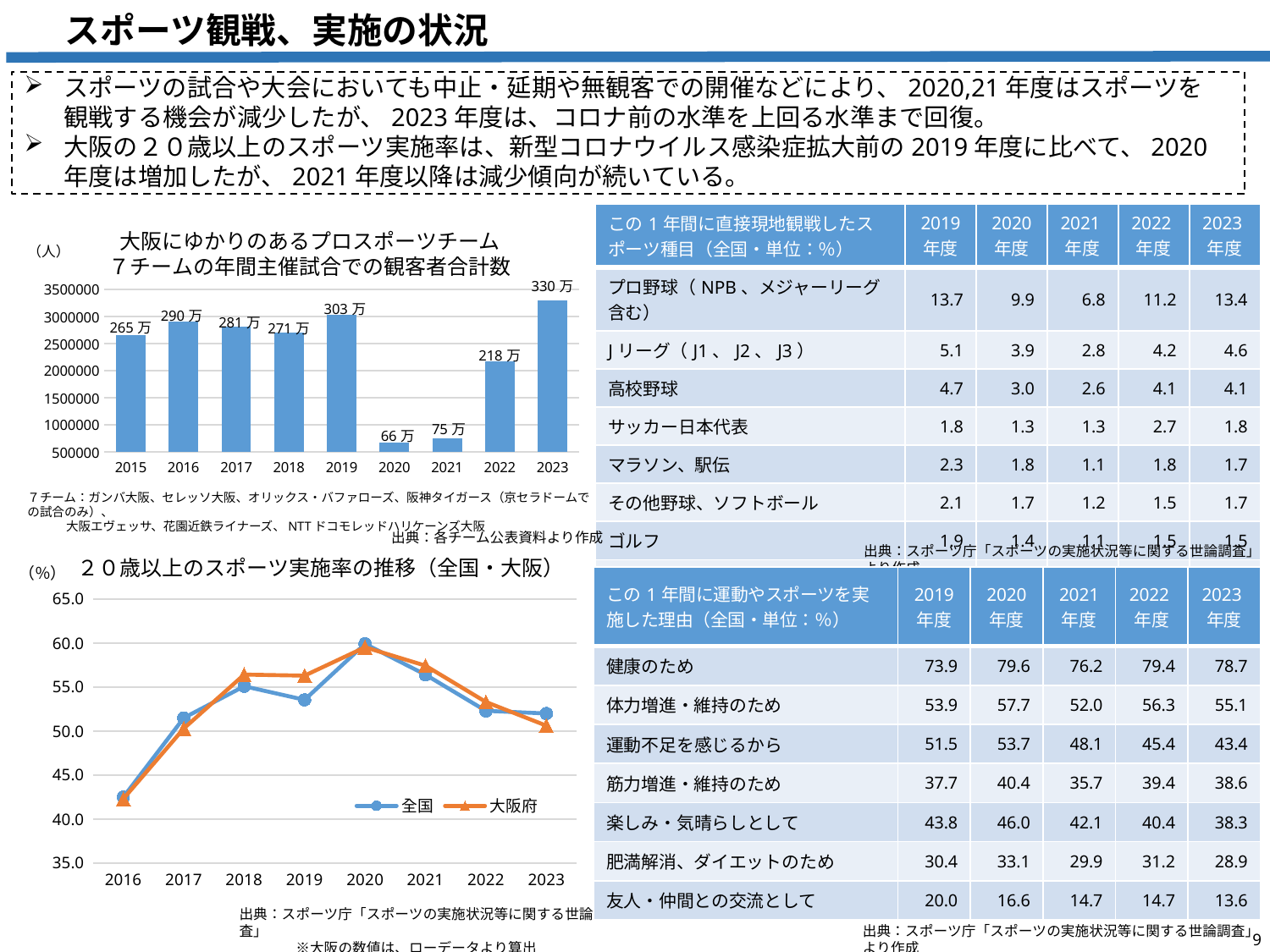
In the bar chart of spectator totals for the 7 Osaka-related pro sports teams, which year has the lowest value? 2020 How many series does the legend list in the line chart of the sports participation rate of people aged 20 and over? 2 What kind of chart is the chart of spectator totals for the 7 Osaka-related pro sports teams? bar chart In the bar chart of spectator totals for the 7 Osaka-related pro sports teams, what is the difference between the 2023 value and the 2020 value? 264万 In the bar chart of spectator totals for the 7 Osaka-related pro sports teams, what is the value for 2019? 303万 In the line chart of the sports participation rate of people aged 20 and over, do the values for 全国 rise or fall from 2020 to 2023? fall In the line chart of the sports participation rate of people aged 20 and over, is the value for 全国 in 2016 greater or less than 45.0? less In the bar chart of spectator totals for the 7 Osaka-related pro sports teams, what is the value for 2022? 218万 In the line chart of the sports participation rate of people aged 20 and over, which is larger in 2019, 全国 or 大阪府? 大阪府 In the bar chart of spectator totals for the 7 Osaka-related pro sports teams, which is larger, the value for 2016 or the value for 2017? 2016 In the bar chart of spectator totals for the 7 Osaka-related pro sports teams, which year has the highest value? 2023 How many years are shown in the bar chart of spectator totals for the 7 Osaka-related pro sports teams? 9